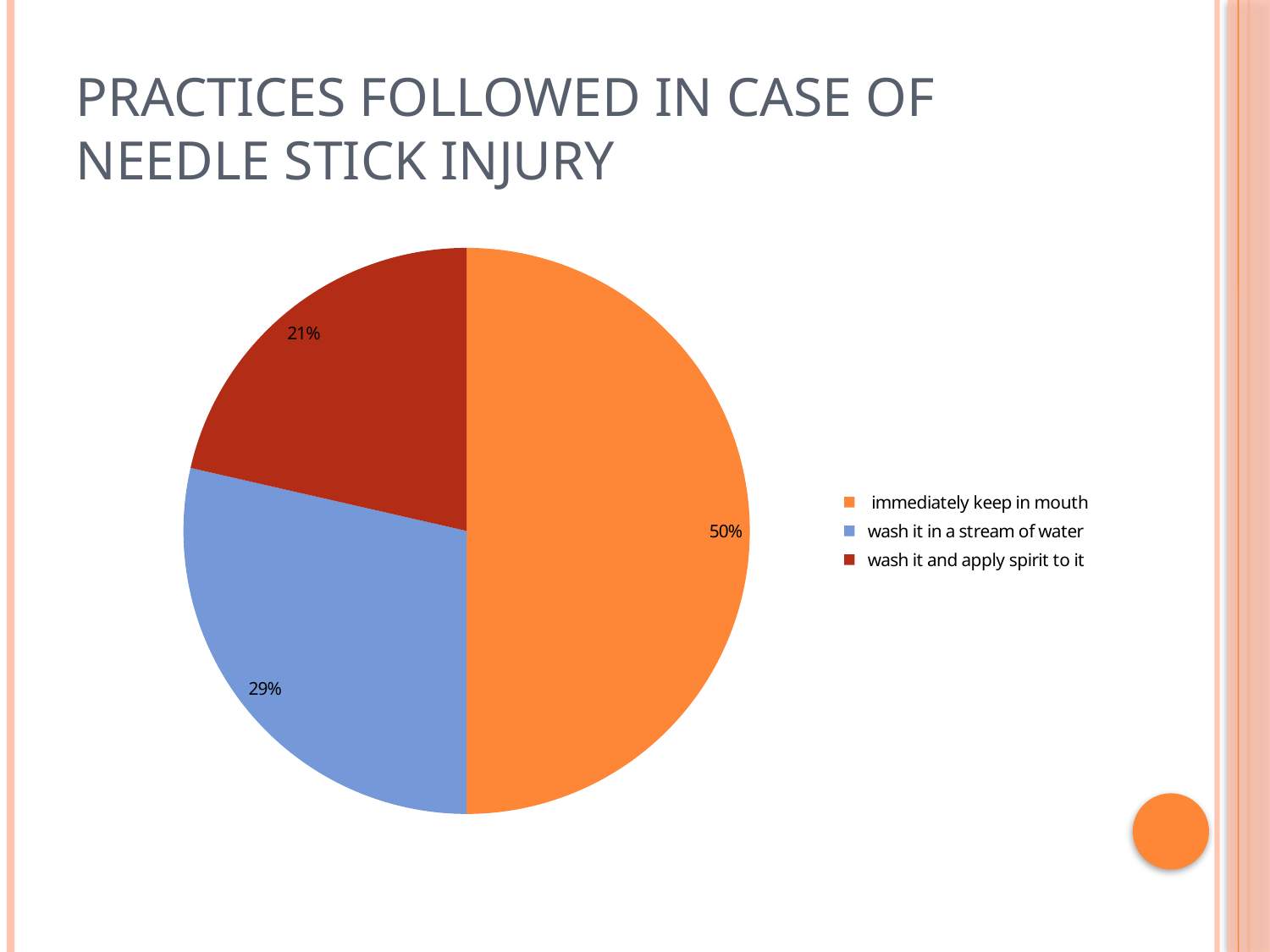
What is the difference in percentage points between 'wash it in a stream of water' and 'wash it and apply spirit to it'? 8 What is the title of the slide containing the pie chart? PRACTICES FOLLOWED IN CASE OF NEEDLE STICK INJURY What share of the pie is 'immediately keep in mouth'? 50% How many slices does the pie chart have? 3 What share of the pie is 'wash it and apply spirit to it'? 21% Which is larger: the share for 'wash it in a stream of water' or 'wash it and apply spirit to it'? wash it in a stream of water Which practice has the largest share of the pie? immediately keep in mouth What share of the pie is 'wash it in a stream of water'? 29% What colour is the slice for 'wash it in a stream of water'? blue Which practice has the smallest share of the pie? wash it and apply spirit to it What is the difference in percentage points between 'immediately keep in mouth' and 'wash it in a stream of water'? 21 What kind of chart is shown on the slide? pie chart